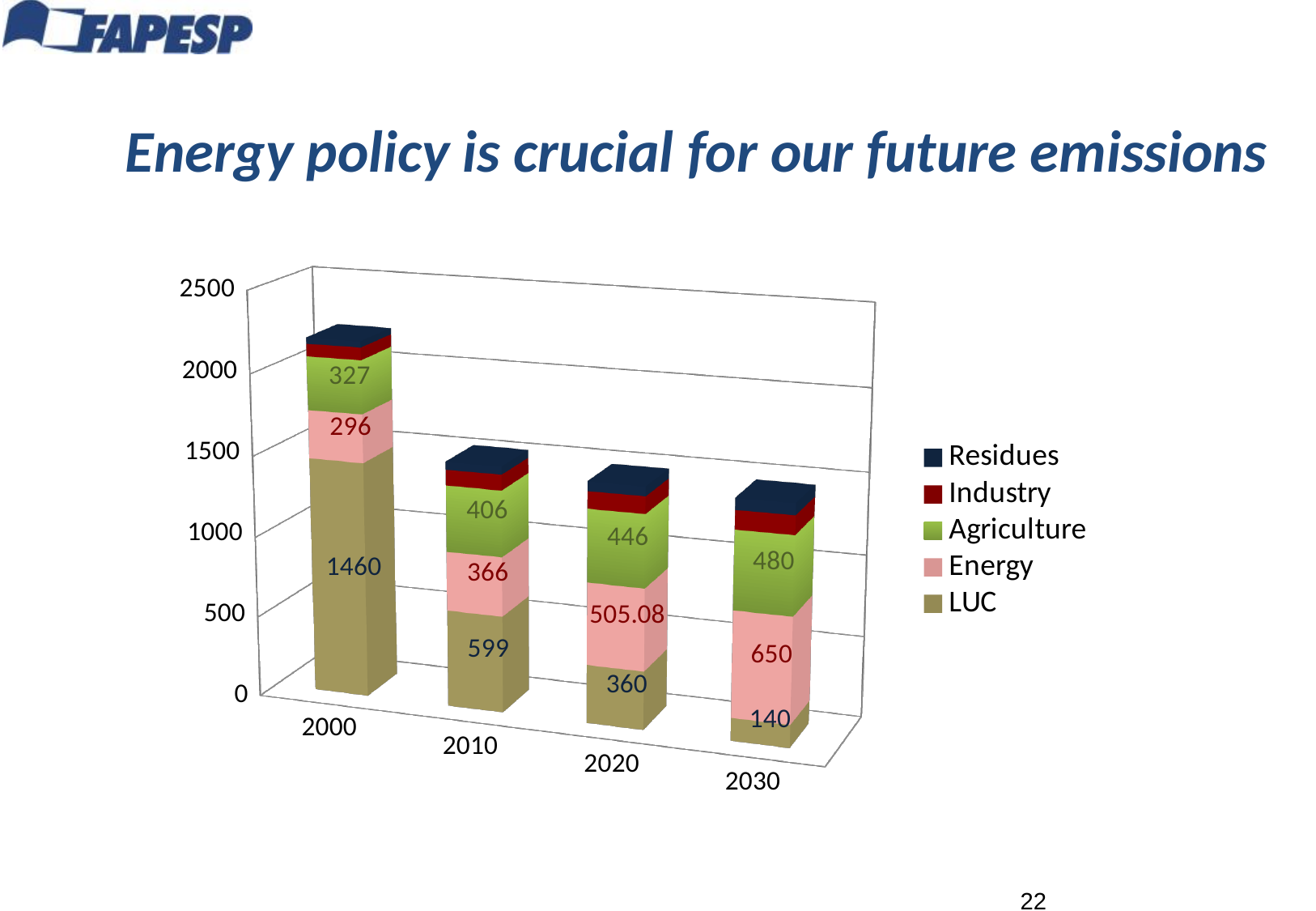
In which year is the LUC value lowest? 2030 What is the Energy value for 2020? 505.08 What kind of chart is shown on the slide? Stacked bar chart What is the LUC value for 2000? 1460 Do the Agriculture values rise or fall from 2000 to 2030? Rise What is the difference between the Energy values for 2030 and 2010? 284 How many years are shown on the x axis? 4 How many series does the legend list? 5 What is the difference between the LUC values for 2000 and 2010? 861 In which year is the Energy value highest? 2030 What is the Agriculture value for 2030? 480 Which is larger in 2020, the Energy value or the Agriculture value? Energy